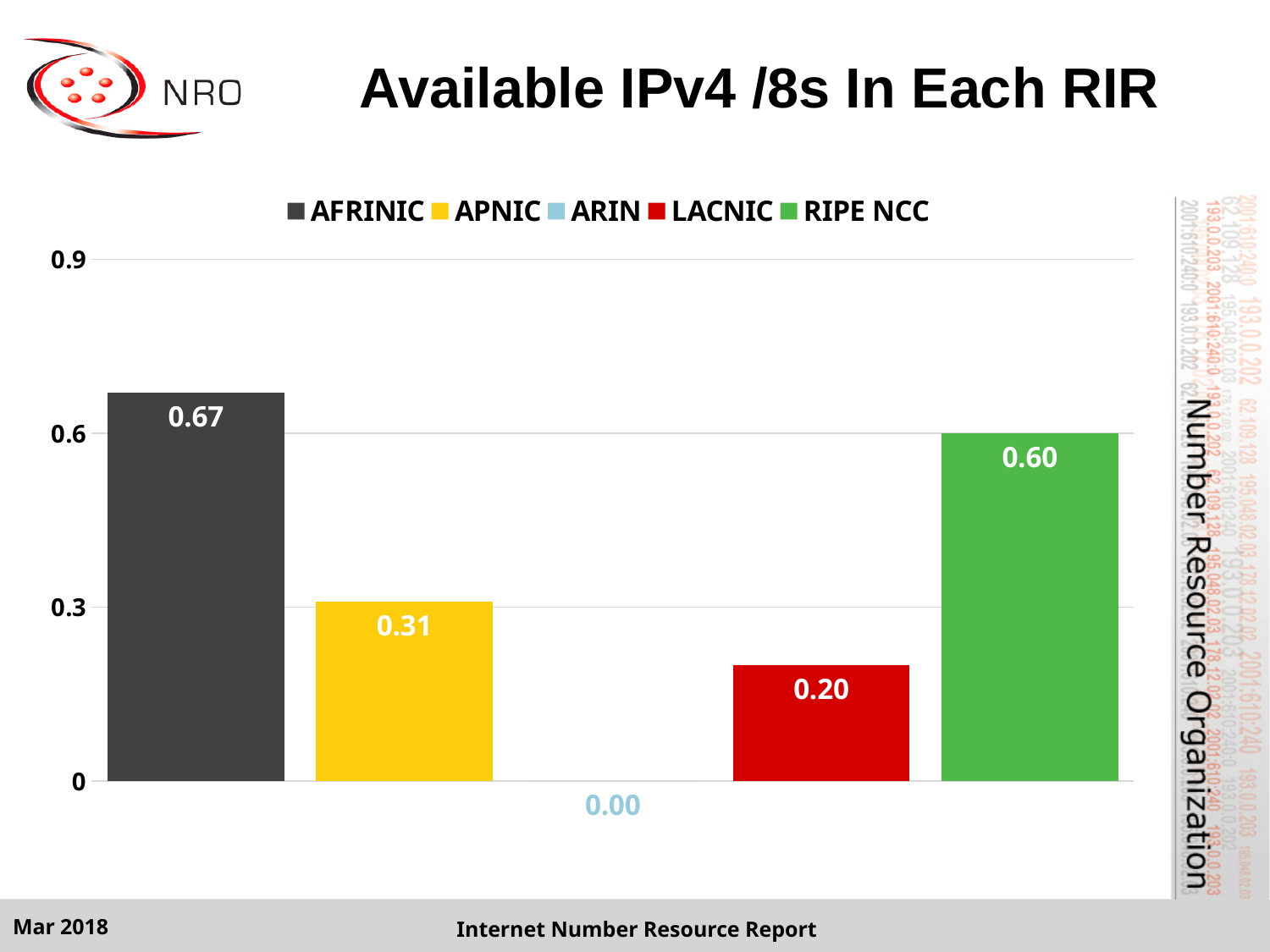
What is the value for ARIN? 0.00 What is the value for AFRINIC? 0.67 What kind of chart is shown on the slide? Bar chart How many RIRs are shown in the chart? 5 Which RIR has the highest number of available IPv4 /8s? AFRINIC Which is larger, the value for APNIC or the value for LACNIC? APNIC What is the difference between the values for AFRINIC and RIPE NCC? 0.07 What is the value for RIPE NCC? 0.60 What is the value for LACNIC? 0.20 What is the value for APNIC? 0.31 What is the title of the chart? Available IPv4 /8s In Each RIR Which RIR has the lowest number of available IPv4 /8s? ARIN